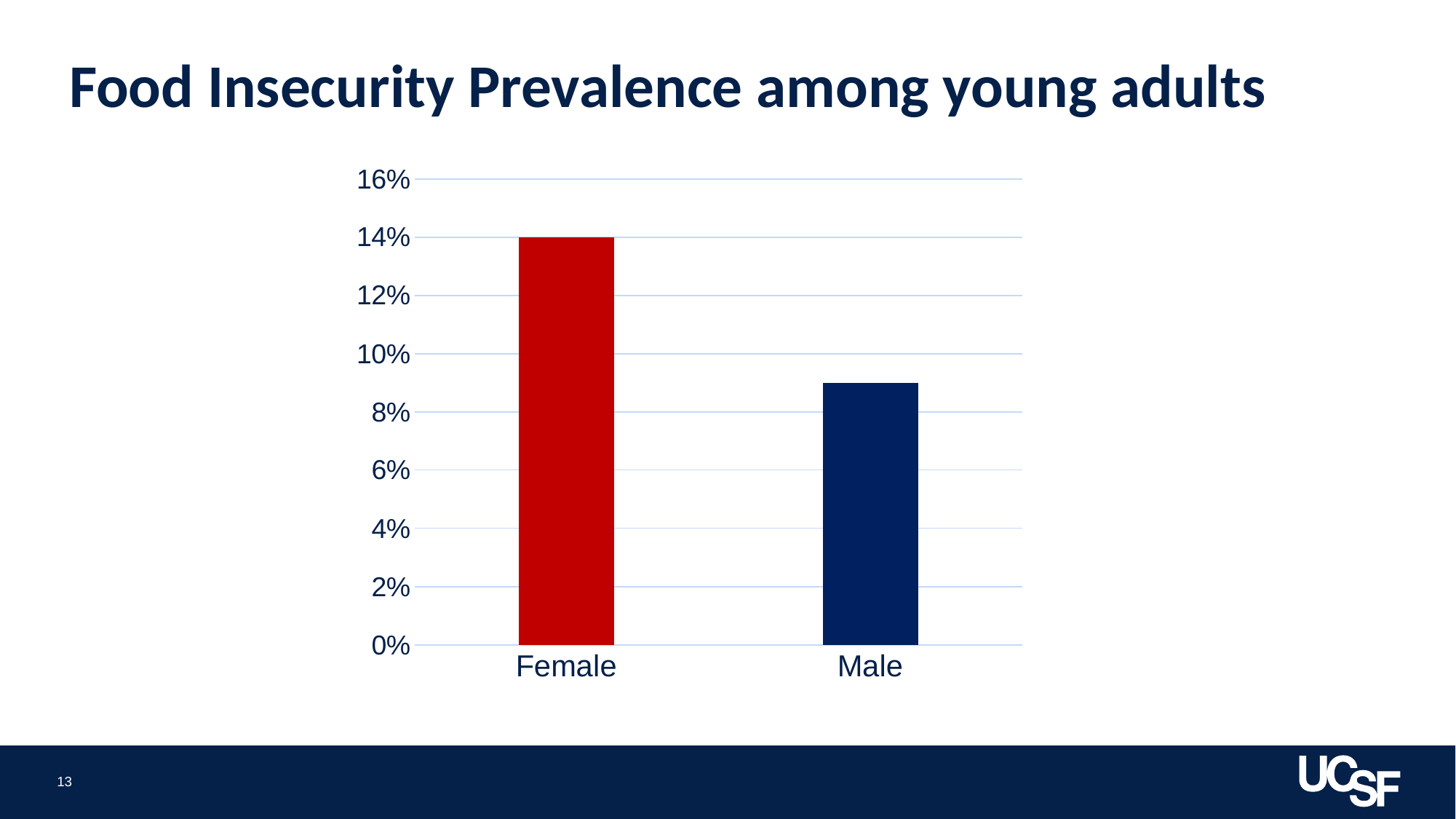
How many categories are plotted in the chart? 2 Which category has the lowest food insecurity prevalence? Male What is the highest value shown on the y axis? 16% Which category has the highest food insecurity prevalence? Female Is the value for Male greater or less than 10%? less What kind of chart is shown on the slide? bar chart Is the value for Male greater or less than 8%? greater Is the value for Female greater or less than 12%? greater What colour is the bar for Female? red What is the food insecurity prevalence for Female? 14% What is the title of the chart on the slide? Food Insecurity Prevalence among young adults Which is larger, the value for Female or the value for Male? Female